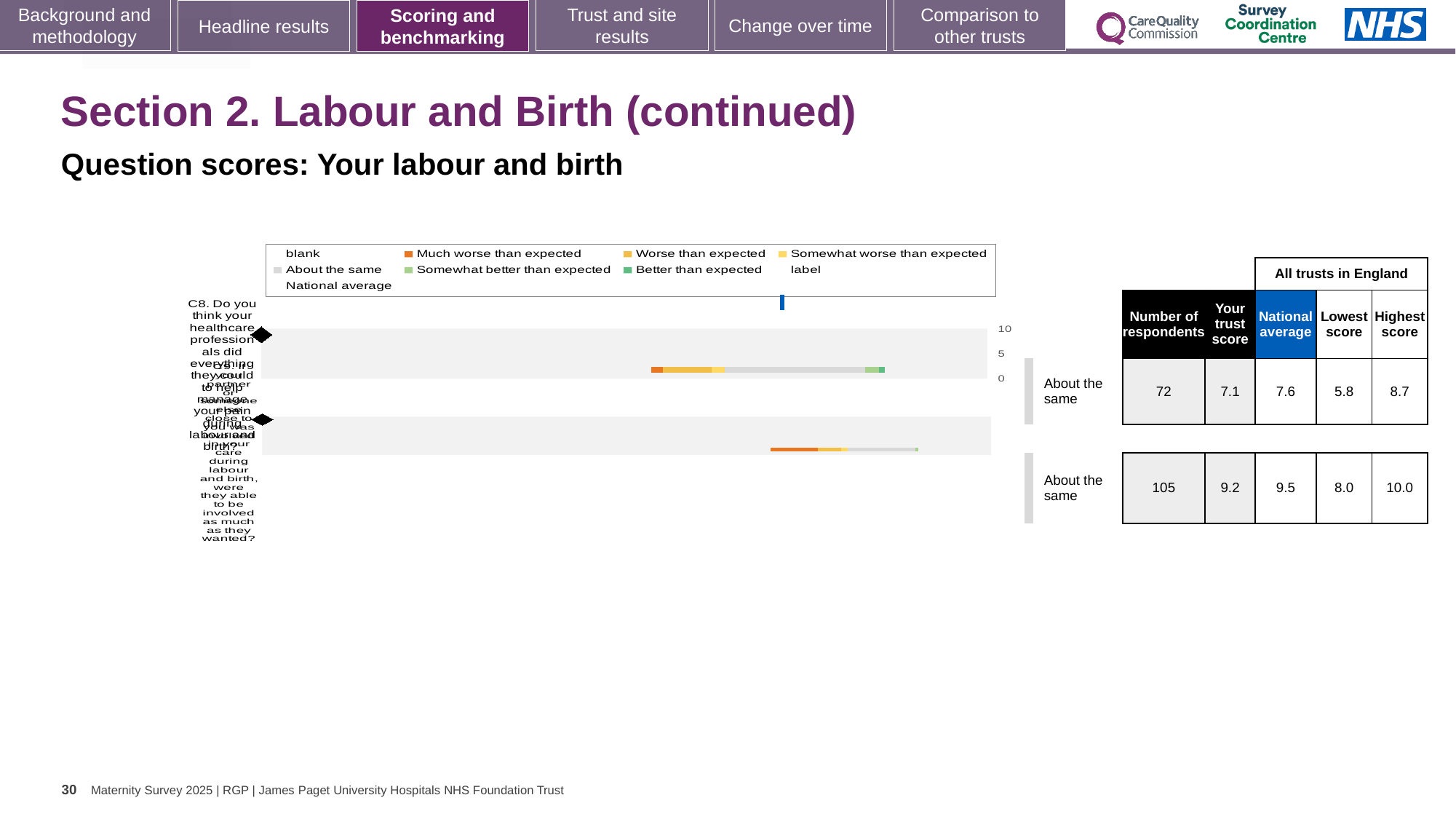
In the table beside the chart, which is larger in the first row: the trust score or the national average? national average In the table beside the chart, what is the highest score in the second row? 10.0 In the chart legend, which colour represents 'About the same'? grey In the chart legend, which colour represents 'Much worse than expected'? orange In the table beside the chart, what is the lowest score in the first row? 5.8 What kind of chart is shown on the slide? bar chart In the table beside the chart, what is the difference between the highest score and the lowest score in the first row? 2.9 In the table beside the chart, what is the 'Your trust score' value in the first row? 7.1 In the table beside the chart, what is the national average in the second row? 9.5 In the table beside the chart, what is the difference between the highest score and the lowest score in the second row? 2.0 In the table beside the chart, which row has more respondents, the first or the second? second In the table beside the chart, what is the number of respondents in the first row? 72